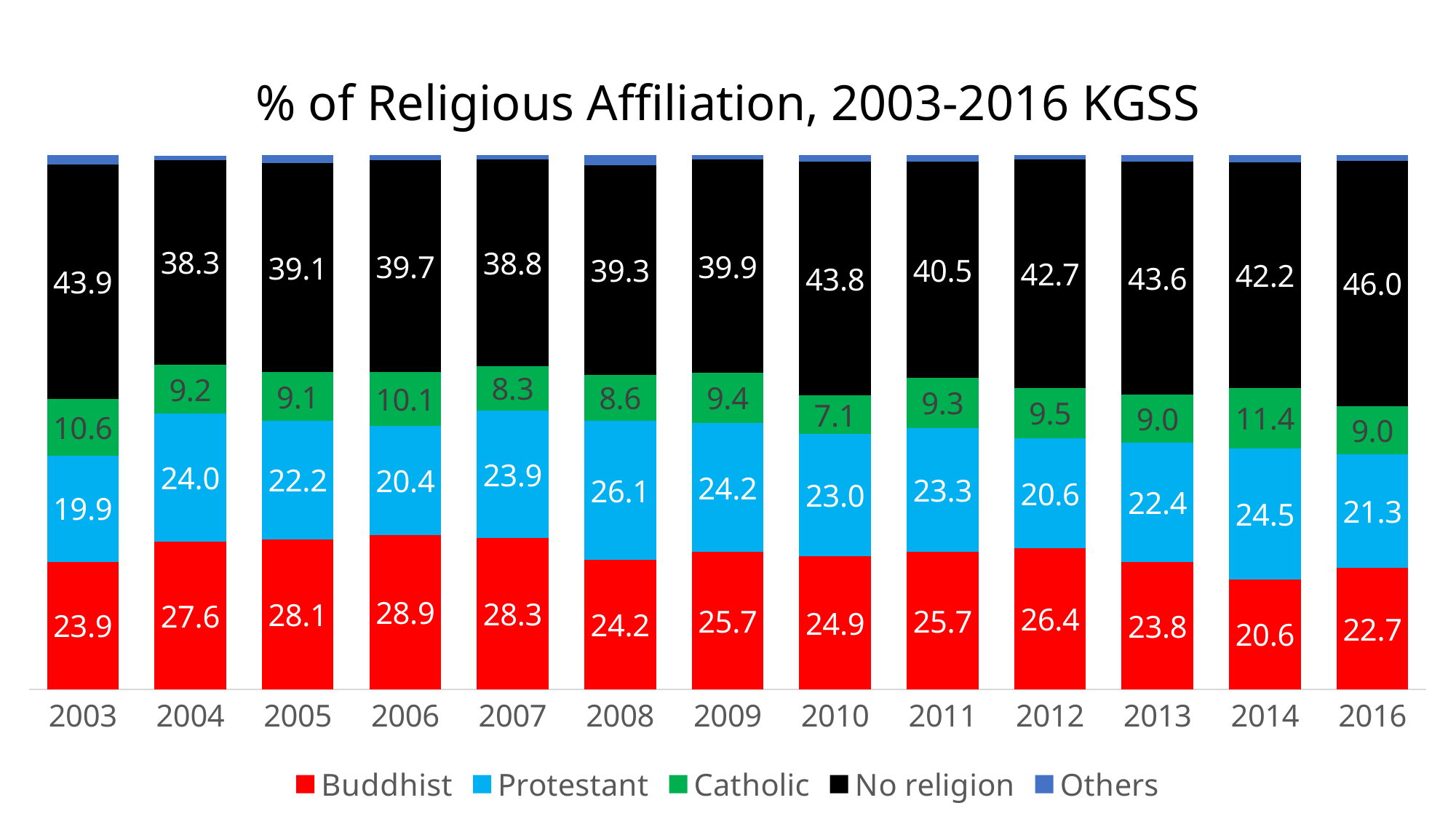
What is the title of the chart? % of Religious Affiliation, 2003-2016 KGSS How many years are shown on the x axis? 13 Which is larger, the Protestant percentage in 2008 or in 2012? 2008 What is the Buddhist percentage for 2006? 28.9 How many series does the legend list? 5 What kind of chart is shown on the slide? Stacked bar chart What is the No religion percentage for 2016? 46.0 What is the difference between the Buddhist percentages in 2006 and 2014? 8.3 In which year is the Catholic percentage lowest? 2010 What is the Catholic percentage for 2014? 11.4 What is the Protestant percentage for 2008? 26.1 In which year is the No religion percentage highest? 2016